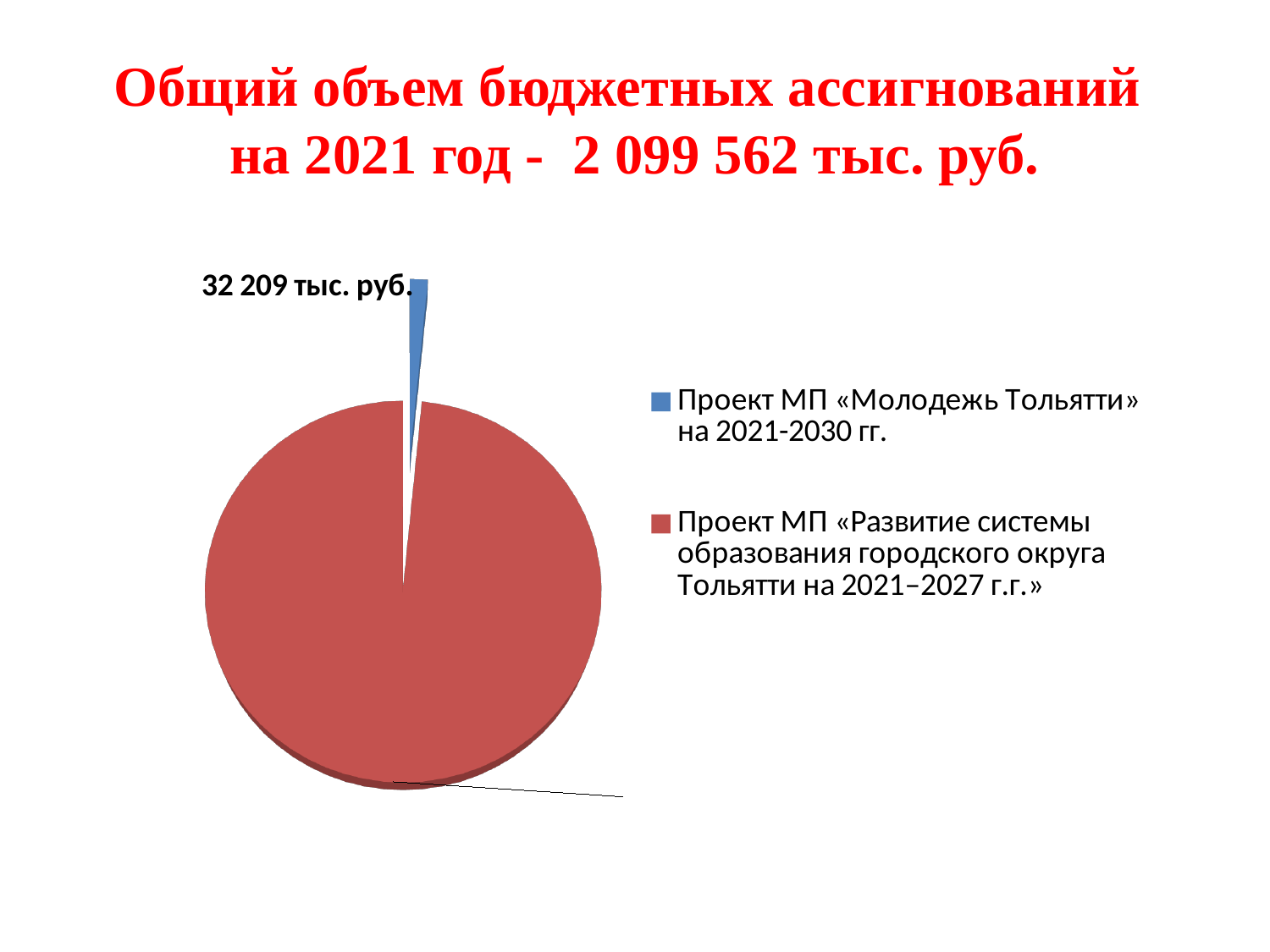
How many entries does the legend of the pie chart list? 2 Which slice of the pie chart is the smallest? Проект МП «Молодежь Тольятти» на 2021-2030 гг. How many slices does the pie chart have? 2 Which is larger: the slice for Проект МП «Молодежь Тольятти» or the slice for Проект МП «Развитие системы образования городского округа Тольятти»? Проект МП «Развитие системы образования городского округа Тольятти на 2021–2027 г.г.» What value is labelled on the slice for Проект МП «Молодежь Тольятти» на 2021-2030 гг.? 32 209 тыс. руб. What kind of chart is shown on the slide? Pie chart Which slice of the pie chart is the largest? Проект МП «Развитие системы образования городского округа Тольятти на 2021–2027 г.г.» What colour is the slice for Проект МП «Молодежь Тольятти» на 2021-2030 гг.? Blue According to the slide title, what is the total volume of budget allocations for 2021? 2 099 562 тыс. руб.